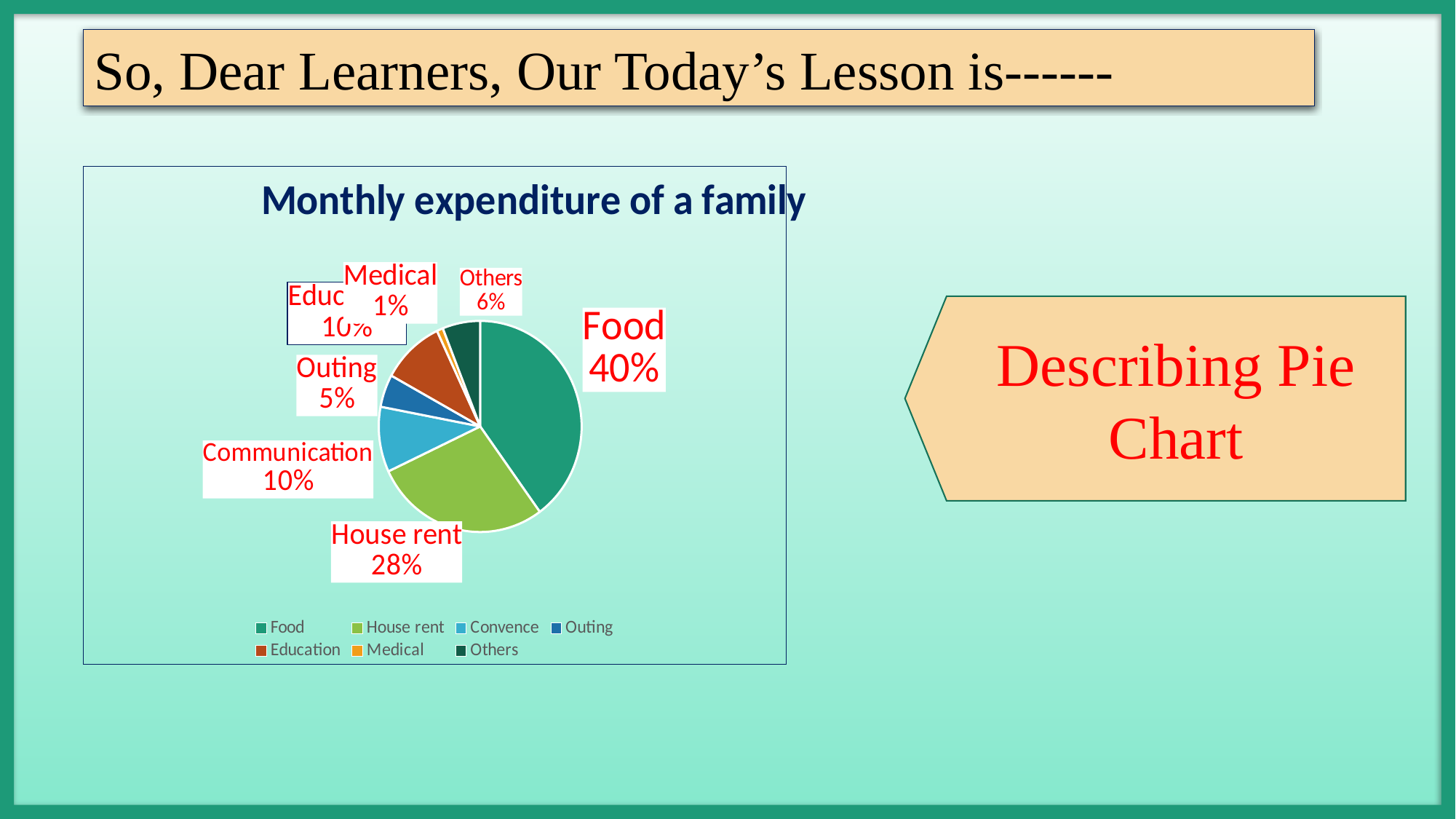
What kind of chart is shown on the slide? pie chart How many percentage points larger is the Food share than the House rent share? 12% What percentage of the monthly expenditure goes to House rent? 28% Which category has the largest share of the pie? Food What is the title of the chart? Monthly expenditure of a family Which is larger, the share for Outing or the share for Others? Others What percentage is shown for Communication? 10% What percentage of the monthly expenditure goes to Food? 40% Which category has the smallest share of the pie? Medical What percentage is shown for Outing? 5% What percentage is shown for Medical? 1% What percentage is shown for Others? 6%